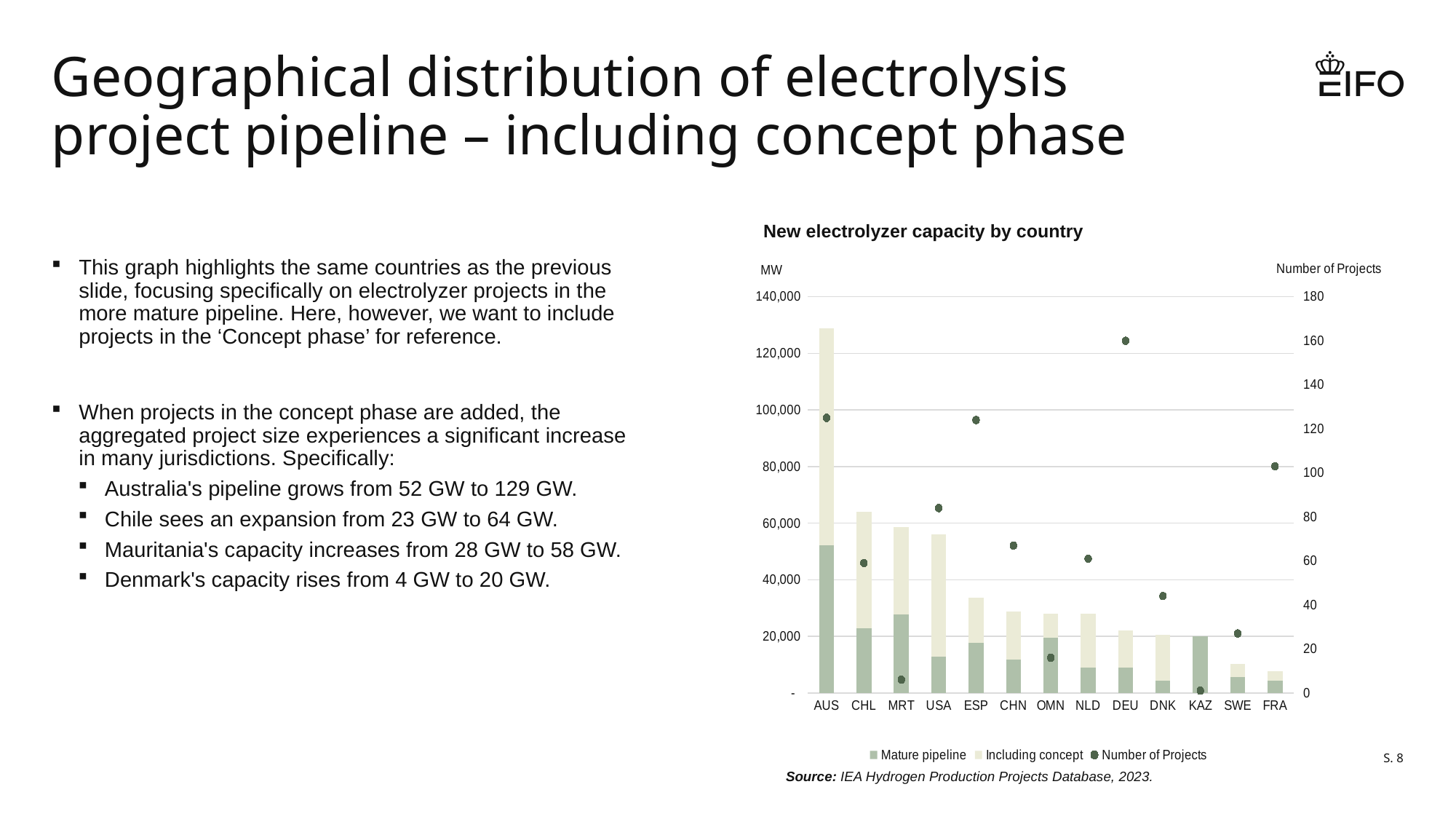
Which country has the shortest total bar in the chart? FRA How many countries are shown on the x axis of the chart? 13 Which has the taller total bar, USA or ESP? USA What kind of chart is used to show the capacity values? Stacked bar chart Is the number of projects for DEU greater or less than 140? greater Do the total bar heights generally rise or fall moving from left to right along the x axis? fall How many series does the chart legend list? 3 What is the title of the chart? New electrolyzer capacity by country Which country has the highest number of projects in the chart? DEU Is the total bar (including concept) for AUS greater or less than 120,000 MW? greater Which country has the tallest total bar (including concept) in the chart? AUS Is the number of projects for KAZ greater or less than 20? less